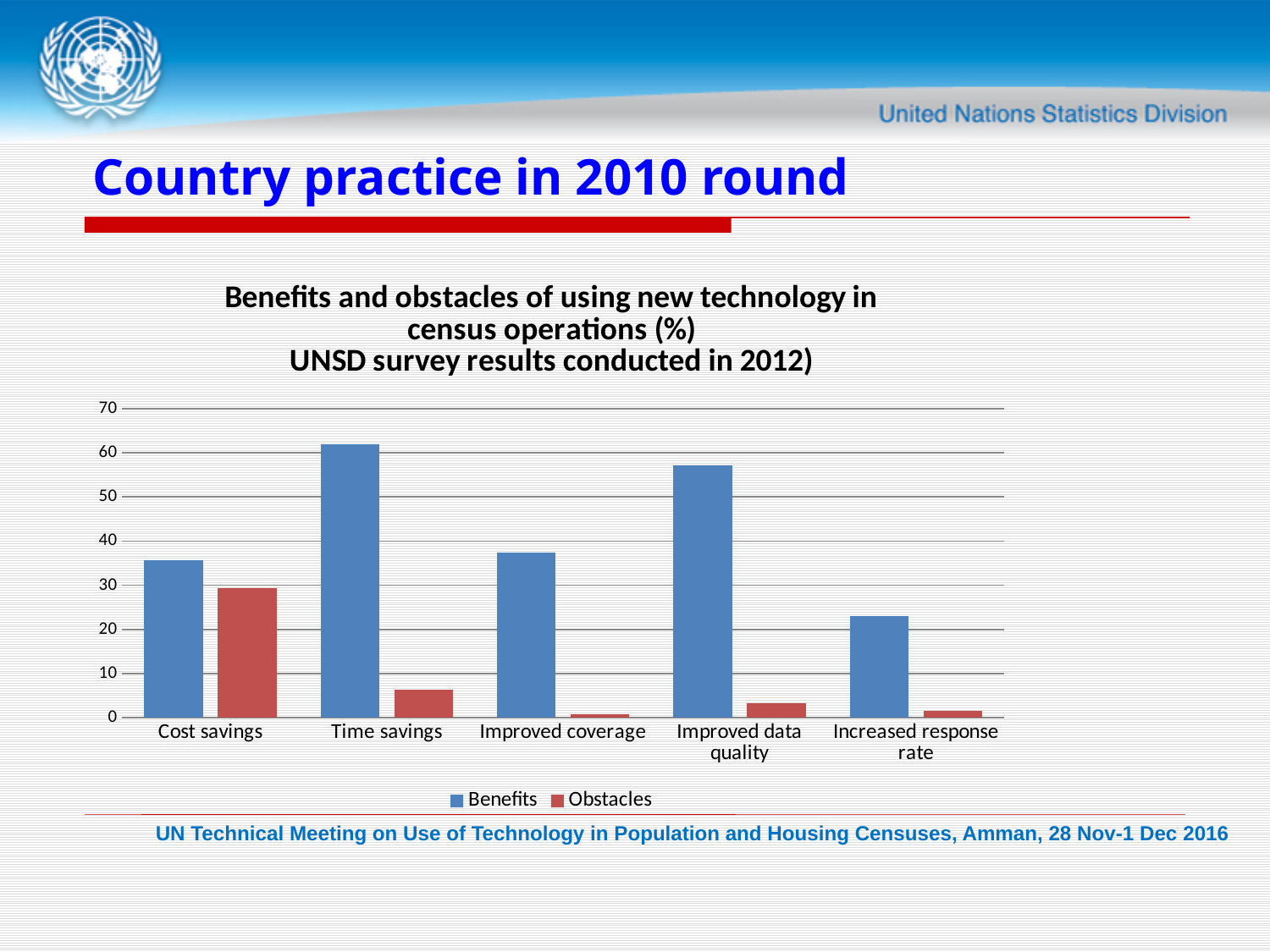
Which category has the highest Benefits value? Time savings Which is larger, the Benefits value for Time savings or the Benefits value for Improved data quality? Time savings Which series is shown in red? Obstacles Is the Benefits value for Increased response rate greater or less than 30? less How many series does the legend list? 2 Which category has the highest Obstacles value? Cost savings Is the Obstacles value for Time savings greater or less than 10? less What kind of chart is shown on the slide? bar chart How many categories are shown on the x axis? 5 Which category has the lowest Benefits value? Increased response rate Is the Benefits value for Improved data quality greater or less than 50? greater